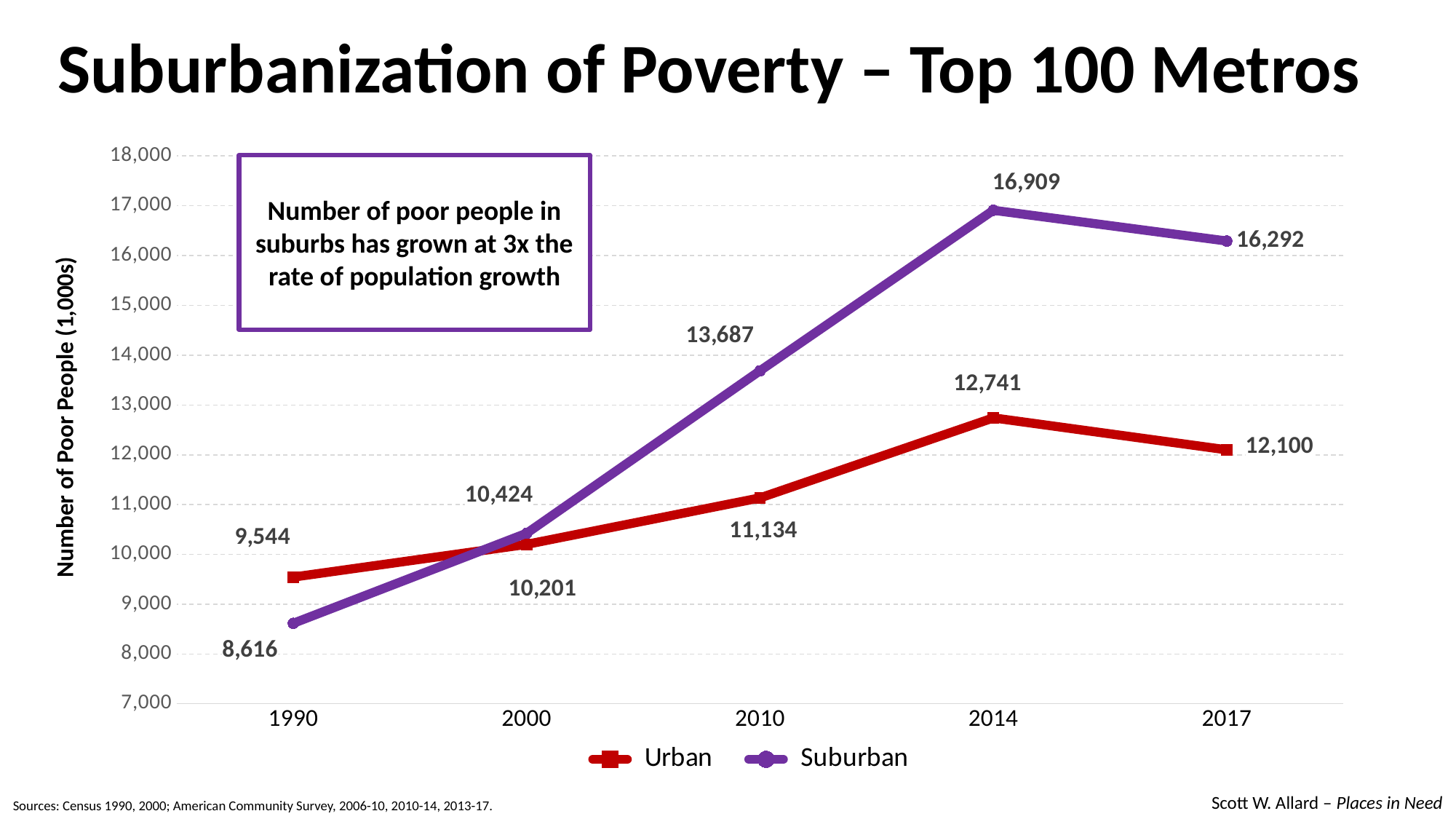
What is the Urban value in 1990? 9,544 Does the Suburban series rise or fall between 1990 and 2014? Rise How many series does the legend list? 2 Which series has the larger value in 1990, Urban or Suburban? Urban What type of chart is shown on the slide? Line chart How many years are plotted along the x axis? 5 In which year is the Urban series at its highest? 2014 In which year is the Suburban series at its lowest? 1990 What is the Suburban value in 2014? 16,909 What is the difference between the Suburban and Urban values in 2017? 4,192 What is the Suburban value in 2017? 16,292 What colour is the Suburban line? Purple